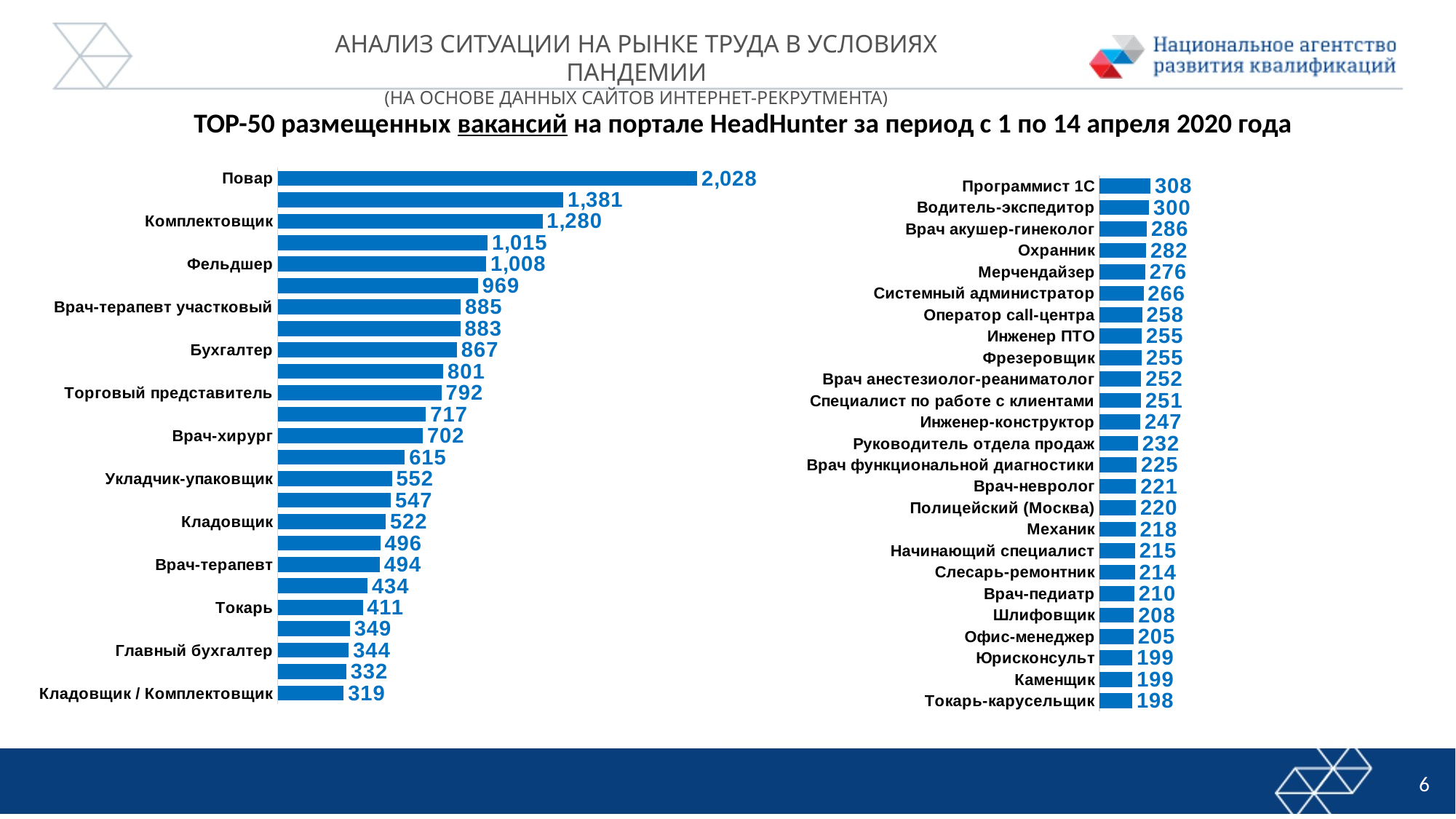
In the left chart, what is the value for Фельдшер? 1,008 In the right chart, what is the value for Врач-педиатр? 210 In the right chart, which category has the highest value? Программист 1С In the left chart, what is the difference between the values for Повар and Комплектовщик? 748 How many bars does the right chart show? 25 In the left chart, what is the value for Повар? 2,028 In the right chart, what is the value for Охранник? 282 In the right chart, which category has the lowest value? Токарь-карусельщик In the left chart, what is the value for Торговый представитель? 792 In the right chart, what is the difference between the values for Водитель-экспедитор and Мерчендайзер? 24 In the left chart, which is larger: the value for Бухгалтер or the value for Врач-хирург? Бухгалтер What kind of chart is the left chart? Bar chart